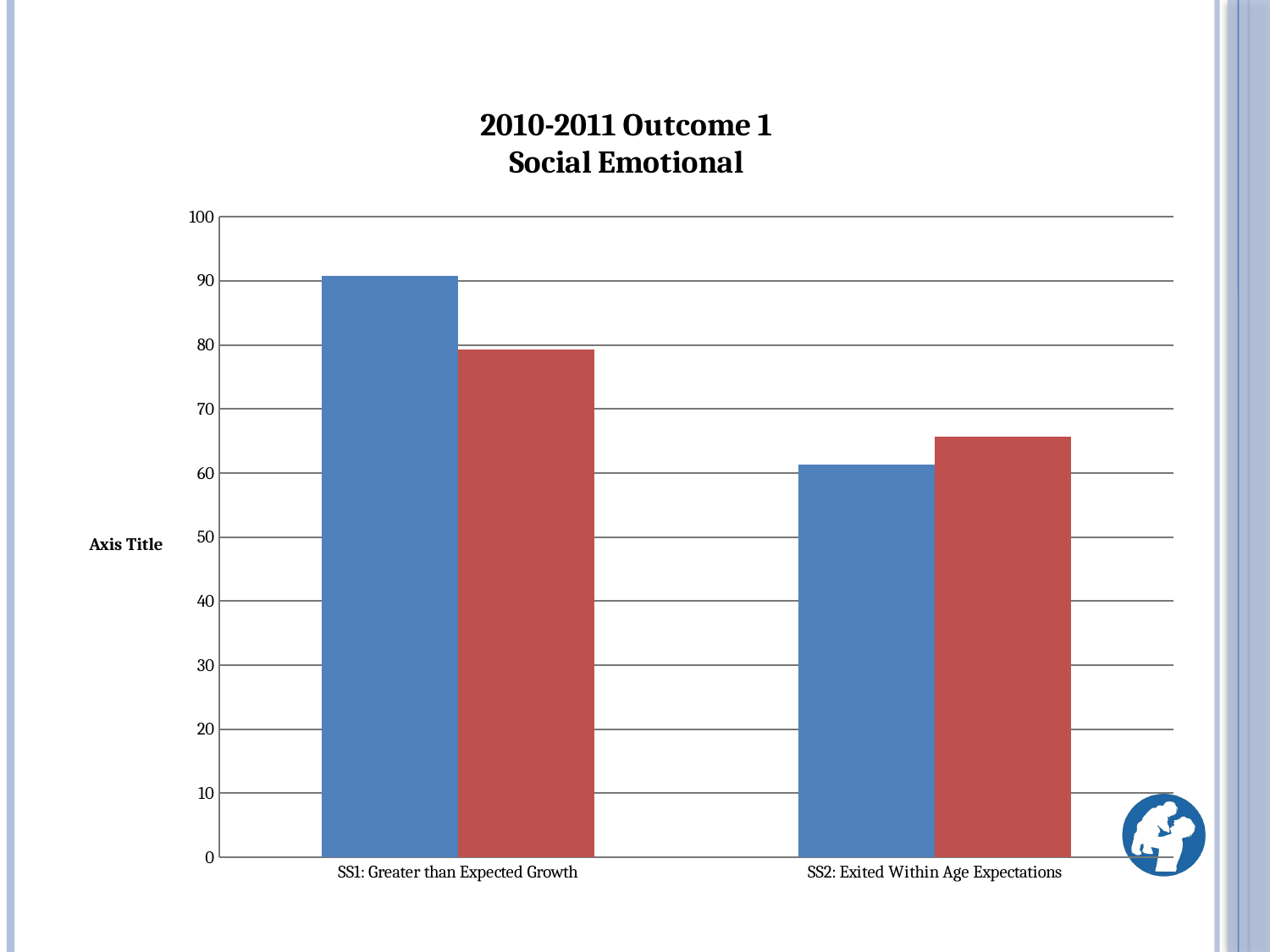
Is the blue bar for SS2: Exited Within Age Expectations greater or less than 70? less Which category has the tallest bar in the chart? SS1: Greater than Expected Growth Is the blue bar for SS1: Greater than Expected Growth greater or less than 80? greater Is the red bar for SS2: Exited Within Age Expectations greater or less than 70? less For SS1: Greater than Expected Growth, which bar is taller, the blue or the red? blue What kind of chart is shown on the slide? bar chart What is the label on the vertical axis? Axis Title How many bars are plotted for each category? 2 What is the title of the chart? 2010-2011 Outcome 1 Social Emotional For SS2: Exited Within Age Expectations, which bar is taller, the blue or the red? red How many categories are shown on the x axis? 2